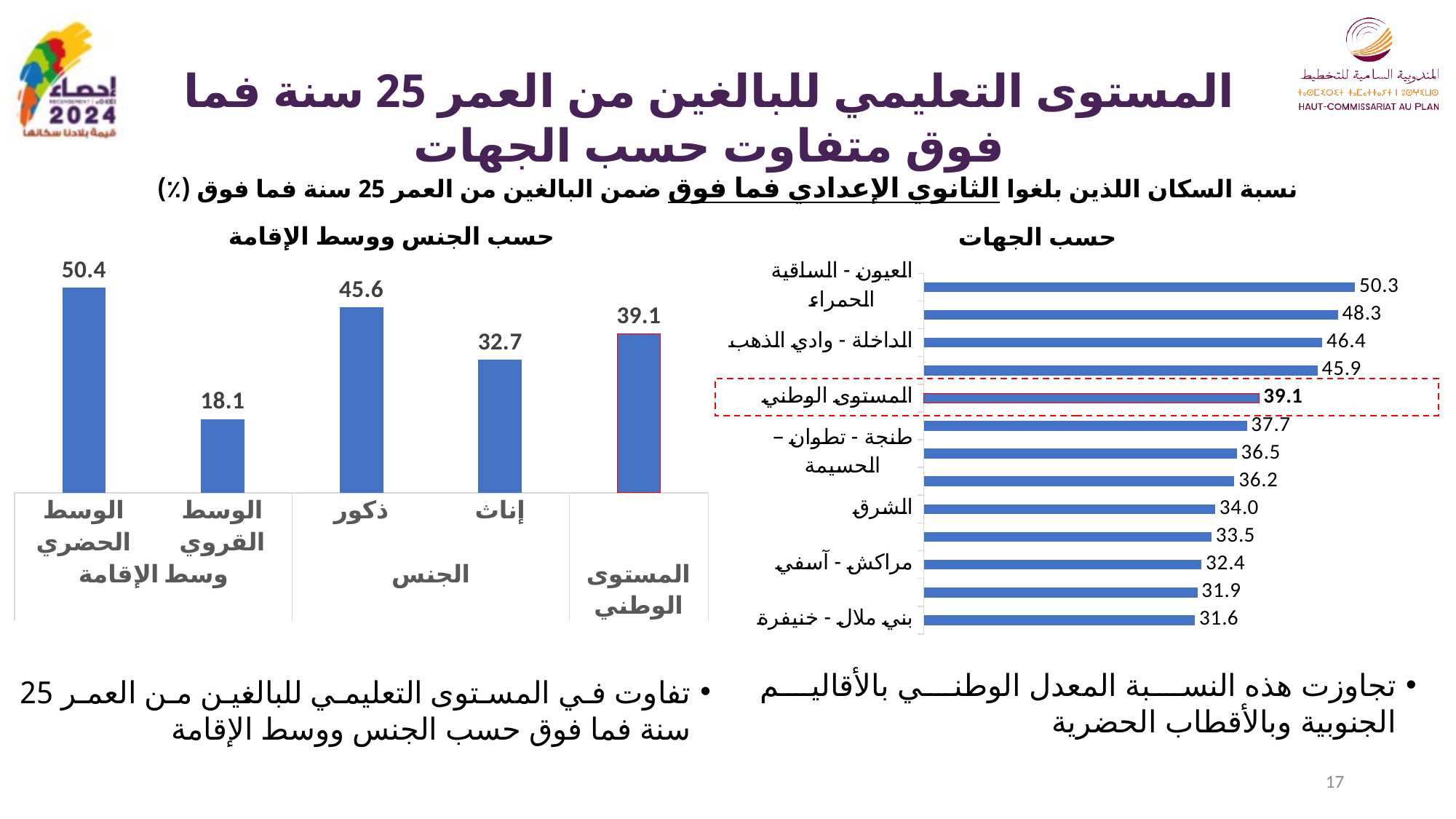
In the chart titled 'حسب الجنس ووسط الإقامة', which category has the lowest value? الوسط القروي In the chart titled 'حسب الجهات', what is the value for بني ملال - خنيفرة? 31.6 In the chart titled 'حسب الجهات', what is the value for المستوى الوطني? 39.1 In the chart titled 'حسب الجهات', how many bars are plotted? 13 In the chart titled 'حسب الجنس ووسط الإقامة', which is larger, the value for الوسط الحضري or the value for ذكور? الوسط الحضري In the chart titled 'حسب الجهات', what is the difference between the values for الداخلة - وادي الذهب and الشرق? 12.4 In the chart titled 'حسب الجنس ووسط الإقامة', how many bars are plotted? 5 In the chart titled 'حسب الجهات', what is the value for العيون - الساقية الحمراء? 50.3 In the chart titled 'حسب الجنس ووسط الإقامة', what is the value for إناث? 32.7 In the chart titled 'حسب الجنس ووسط الإقامة', what is the difference between the values for ذكور and إناث? 12.9 What type of chart is the chart titled 'حسب الجهات'? Bar chart In the chart titled 'حسب الجنس ووسط الإقامة', what is the value for الوسط الحضري? 50.4